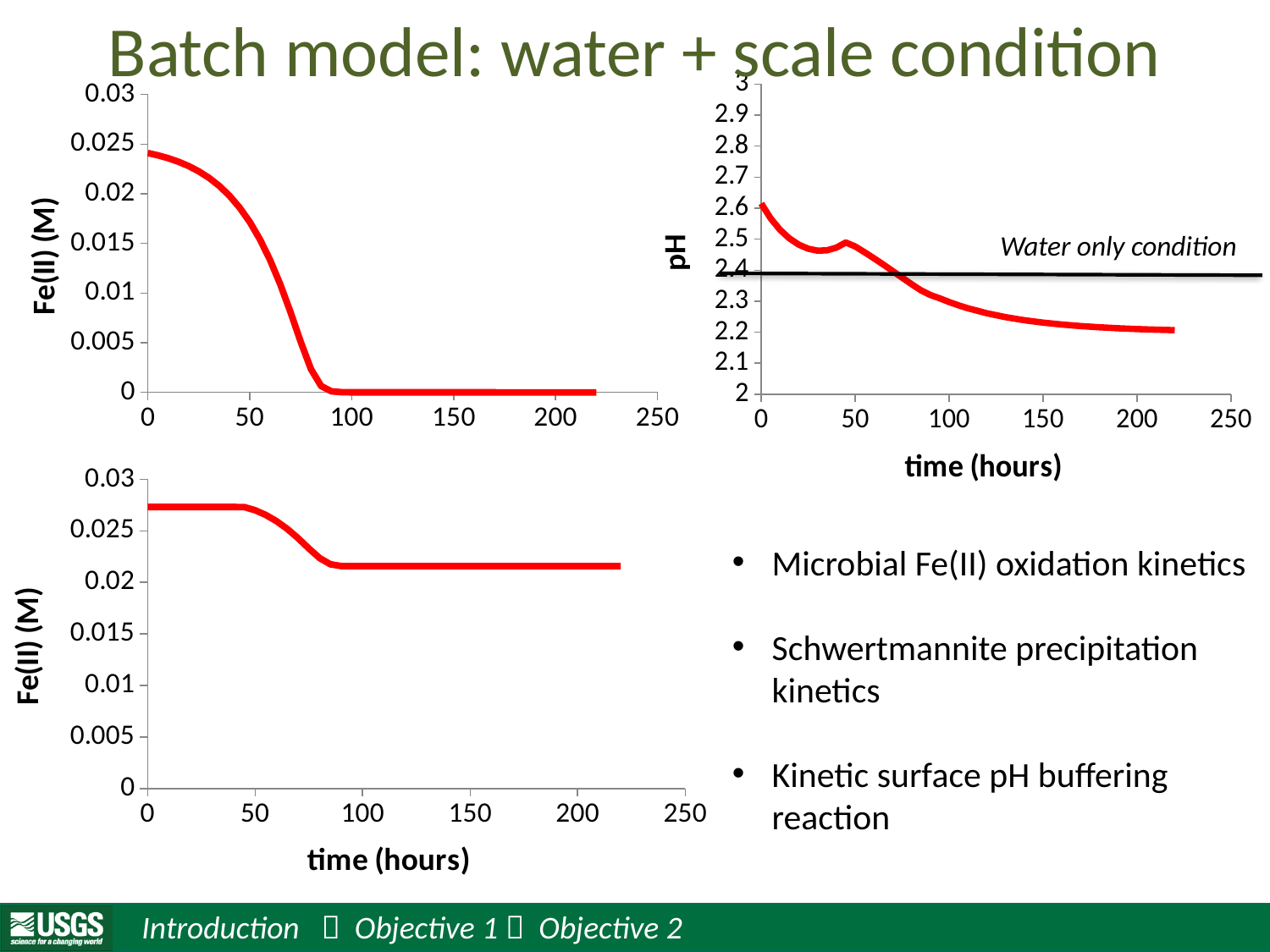
What is the y-axis title of the top-right chart? pH In the top-right pH chart, is the pH of the red line at time 0 greater or less than 2.5? greater In the top-left Fe(II) chart, is the Fe(II) value at 150 hours greater or less than 0.005? less In the bottom-left Fe(II) chart, is the Fe(II) value at 200 hours greater or less than 0.02? greater How many charts are shown on the slide? 3 In the top-right pH chart, does the red line overall rise or fall as time increases? fall What kind of chart is the top-left chart showing Fe(II) (M) against time (hours)? line chart In the top-left Fe(II) chart, does the Fe(II) concentration rise or fall as time increases? fall In the top-right pH chart, what label is given to the flat black line? Water only condition